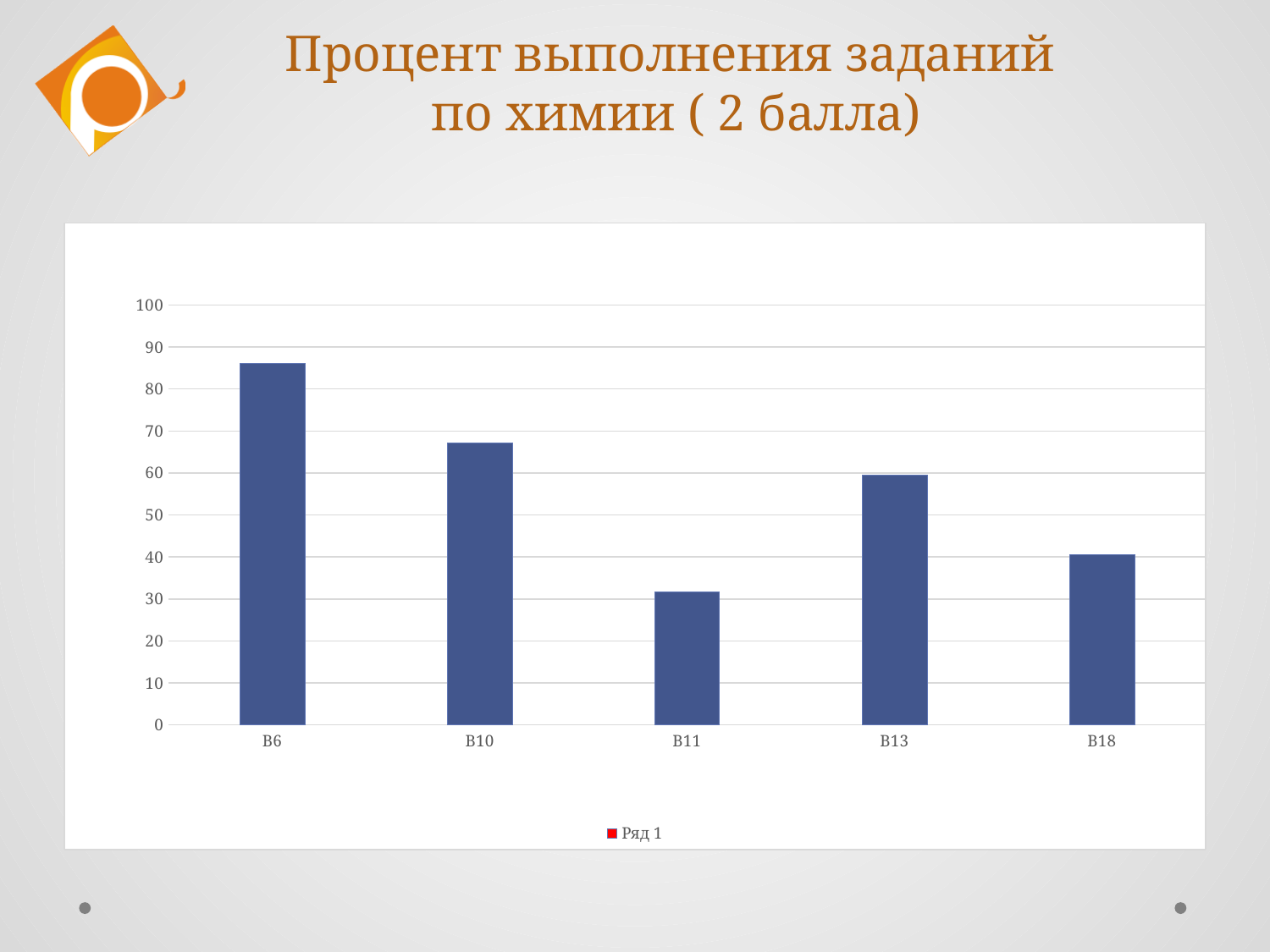
What kind of chart is shown on the slide? bar chart Is the value for B11 greater or less than 40? less Which category has the highest value? B6 How many series does the legend list? 1 Is the value for B6 greater or less than 80? greater Is the value for B18 greater or less than 50? less What is the name of the series shown in the legend? Ряд 1 Which is larger, the value for B10 or the value for B13? B10 How many categories are plotted on the x axis? 5 Which category has the lowest value? B11 Which is larger, the value for B18 or the value for B11? B18